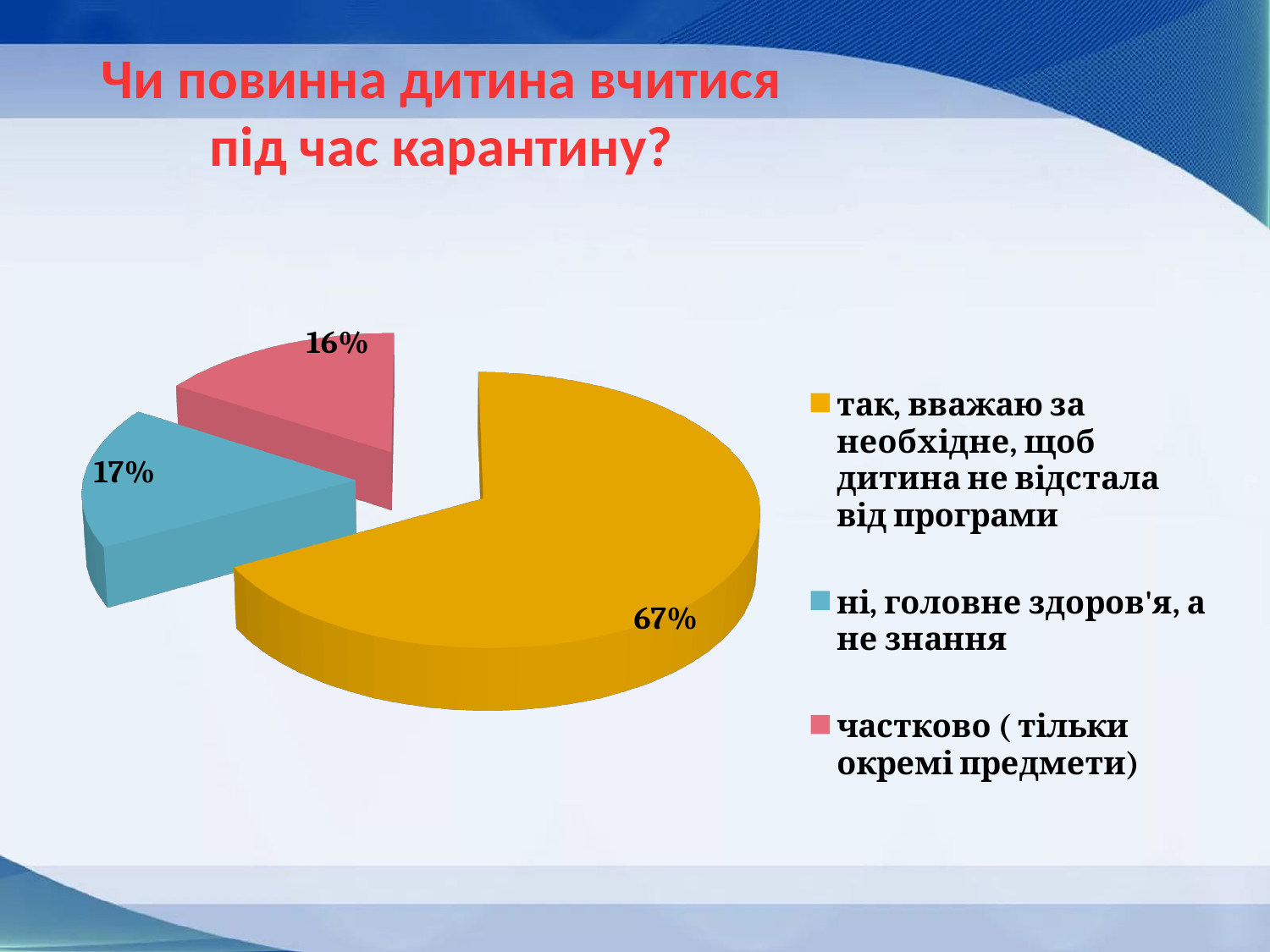
What share of the pie corresponds to "ні, головне здоров'я, а не знання"? 17% Which is larger: the share for "ні, головне здоров'я, а не знання" or the share for "частково ( тільки окремі предмети)"? ні, головне здоров'я, а не знання How many entries does the legend list? 3 What colour is the slice for "ні, головне здоров'я, а не знання"? blue What kind of chart is shown on the slide? pie chart What is the title of the slide containing the pie chart? Чи повинна дитина вчитися під час карантину? Which category has the largest slice of the pie? так, вважаю за необхідне, щоб дитина не відстала від програми What is the difference in percentage points between the "так" slice and the "ні" slice? 50 What share of the pie corresponds to "частково ( тільки окремі предмети)"? 16% Which category has the smallest slice of the pie? частково ( тільки окремі предмети) How many slices does the pie chart have? 3 What share of the pie corresponds to "так, вважаю за необхідне, щоб дитина не відстала від програми"? 67%